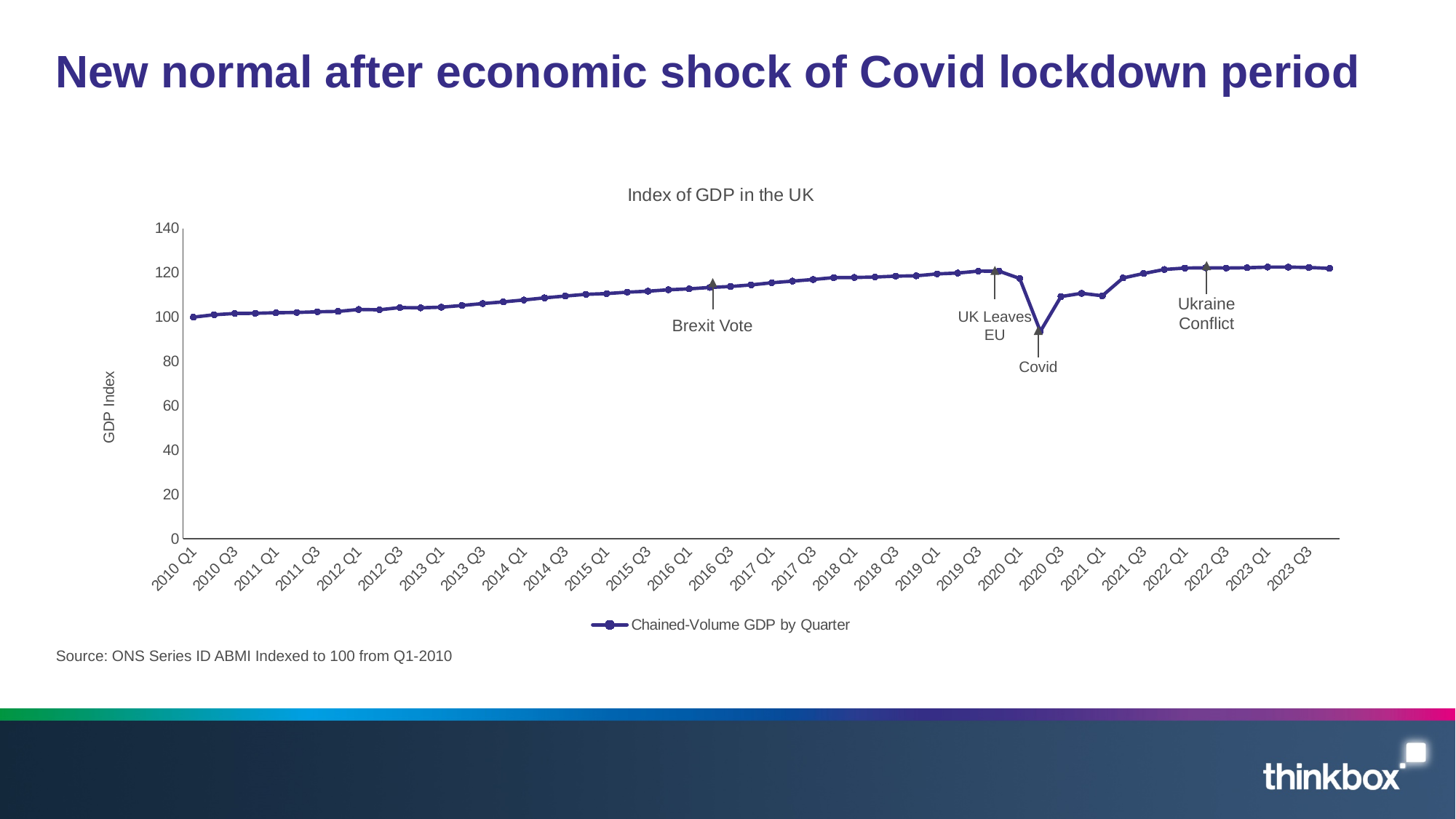
What is the GDP Index value for 2010 Q1? 100 What kind of chart is shown on the slide? Line chart Is the value for 2023 Q3 greater or less than 100? greater Which point on the line has the lowest GDP Index value? The point marked Covid What is the name of the series shown in the legend? Chained-Volume GDP by Quarter How many series does the legend list? 1 Does the GDP Index rise or fall from 2010 Q1 to 2019 Q3? Rise Is the value at the point marked Brexit Vote greater or less than 100? greater Which is larger, the value at the Brexit Vote point or the value at the Covid point? Brexit Vote What is the title of the chart? Index of GDP in the UK Is the value at the point marked Covid greater or less than 100? less